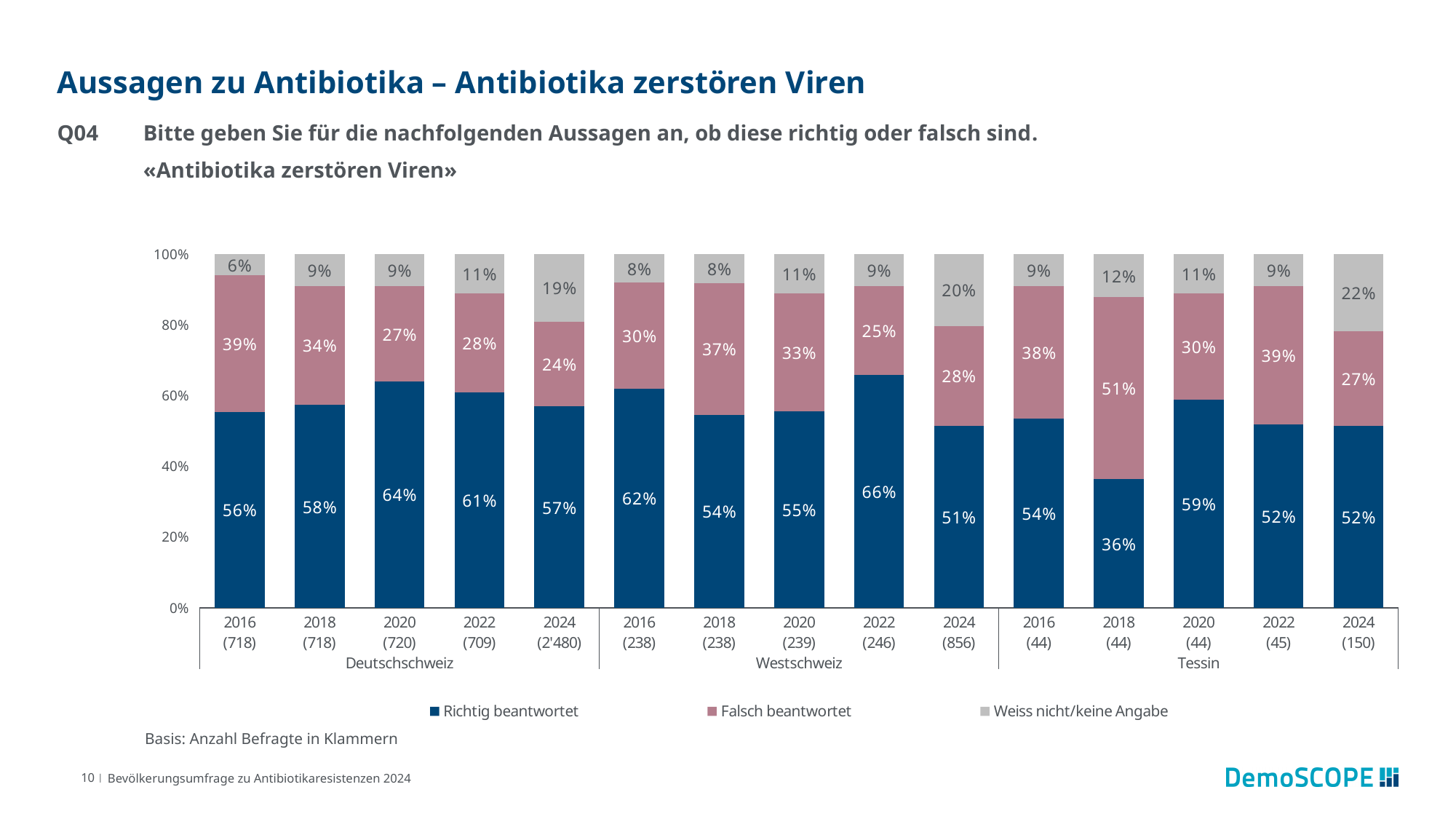
What type of chart is shown? Stacked bar chart How many bars are shown in the chart? 15 Which bar has the highest 'Richtig beantwortet' share? Westschweiz 2022 (66%) Which bar has the highest 'Weiss nicht/keine Angabe' share? Tessin 2024 (22%) Which bar has the lowest 'Richtig beantwortet' share? Tessin 2018 (36%) What is the 'Weiss nicht/keine Angabe' share for Westschweiz in 2024? 20% By how many percentage points did 'Richtig beantwortet' in Deutschschweiz fall from 2020 to 2024? 7 percentage points Which is larger: the 'Falsch beantwortet' share for Westschweiz 2018 or for Tessin 2022? Tessin 2022 (39%) What percentage answered correctly (Richtig beantwortet) in Deutschschweiz in 2020? 64% What is the share of 'Falsch beantwortet' for Tessin in 2018? 51% How many series does the legend list? 3 Does the 'Weiss nicht/keine Angabe' share in Deutschschweiz rise or fall from 2016 to 2024? Rises